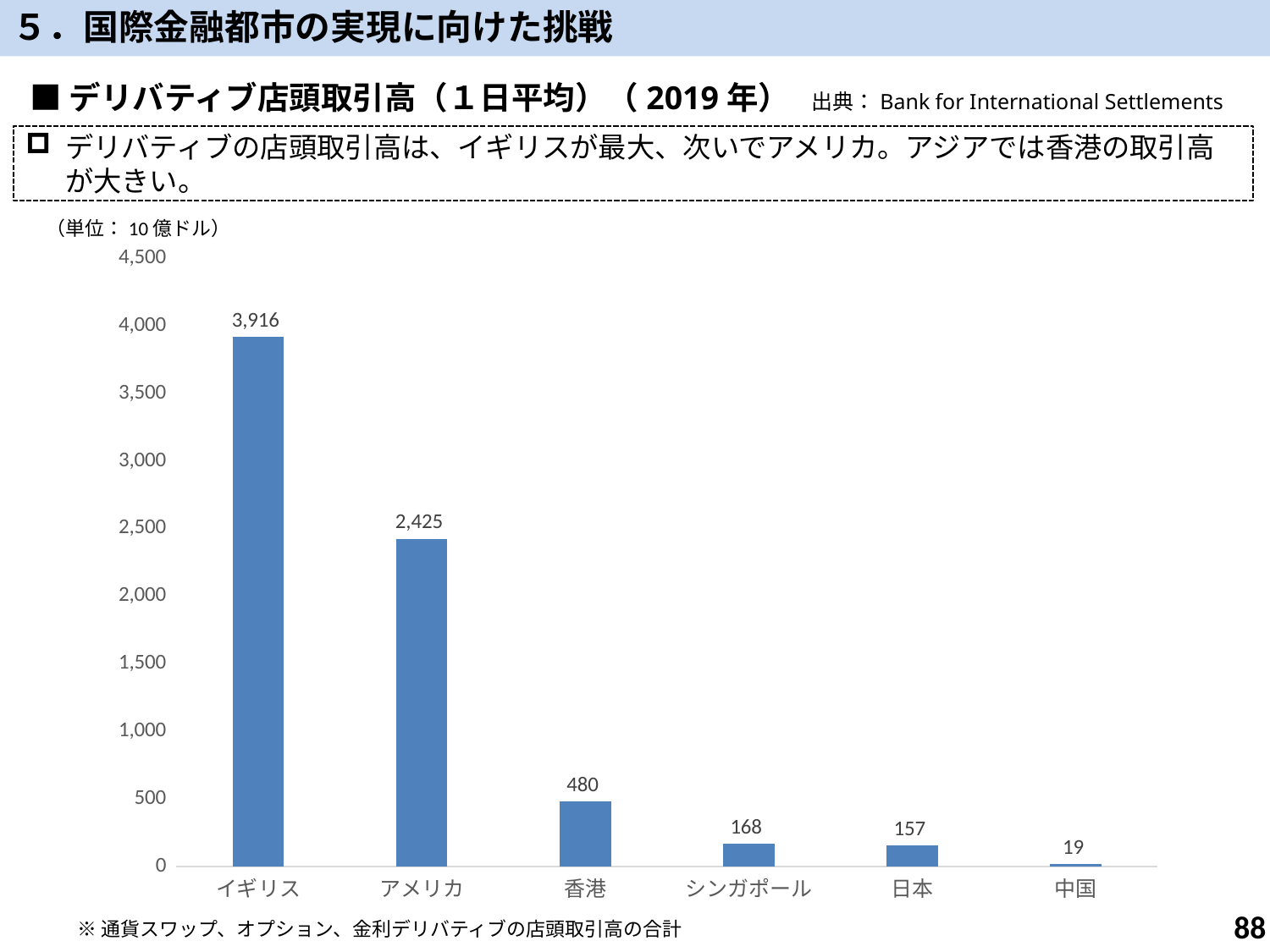
Which is larger, the value for 香港 or the value for シンガポール? 香港 What is the value for 香港? 480 What is the difference between the values for イギリス and アメリカ? 1,491 What is the value for イギリス? 3,916 What is the difference between the values for シンガポール and 日本? 11 What is the value for 日本? 157 How many categories are shown on the x axis? 6 Is the value for アメリカ greater or less than 2,000? greater What unit is stated for the values in the chart? 10億ドル What kind of chart is shown on the slide? bar chart Which category has the highest value? イギリス Which category has the lowest value? 中国